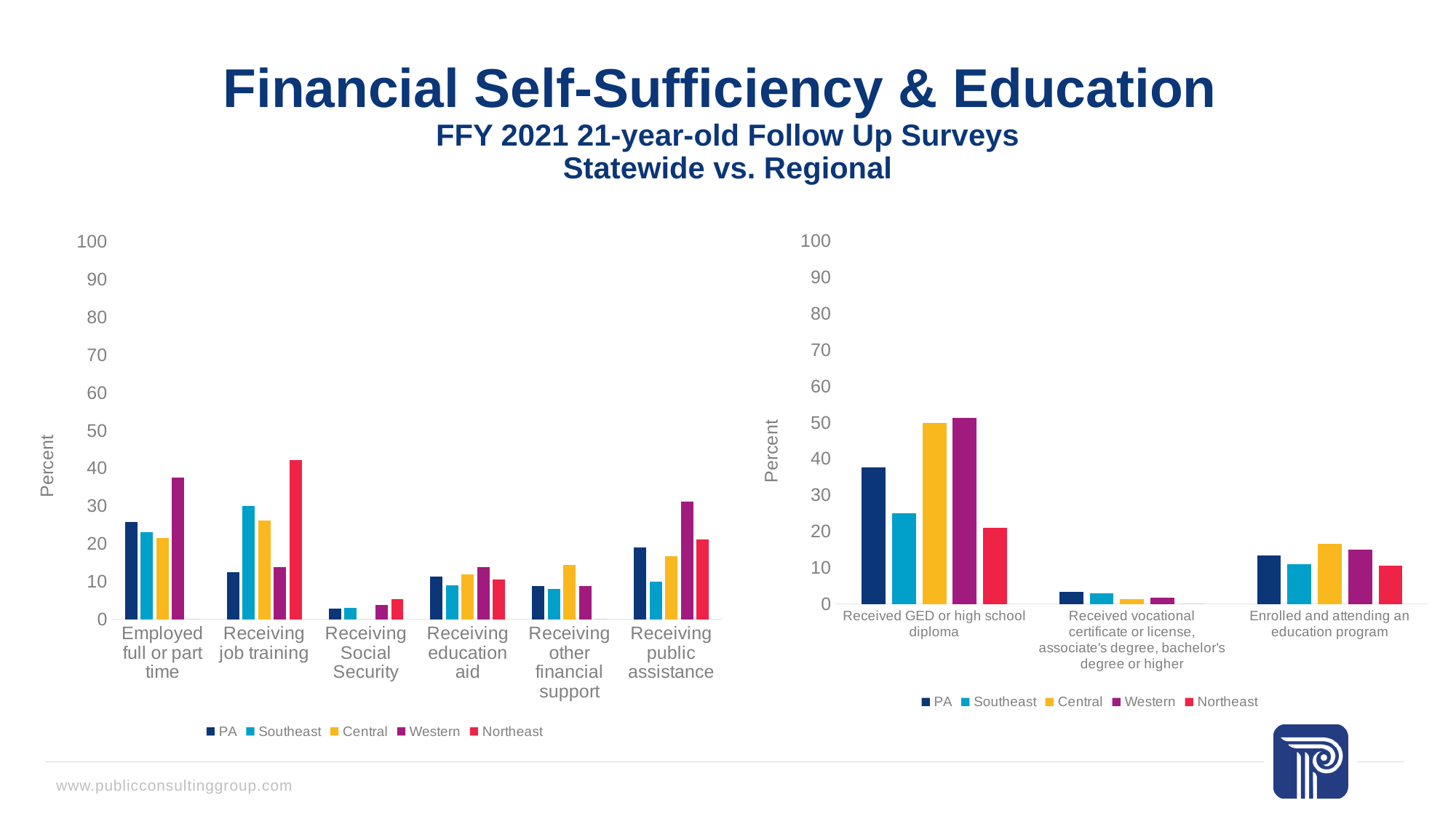
How many categories are shown on the left chart's x axis? 6 What kind of chart is the right chart? Bar chart On the right chart, is the PA value for Received GED or high school diploma greater or less than 30? greater On the left chart, is the PA value for Receiving Social Security greater or less than 10? less On the left chart, which series has the highest bar for Employed full or part time? Western On the left chart, is the Northeast value for Receiving job training greater or less than 40? greater On the left chart, which region has the highest bar for Receiving job training? Northeast On the left chart, which is larger for Receiving public assistance: the Western bar or the Southeast bar? Western On the right chart, which series has the highest bar for Enrolled and attending an education program? Central How many series does the legend of the right chart list? 5